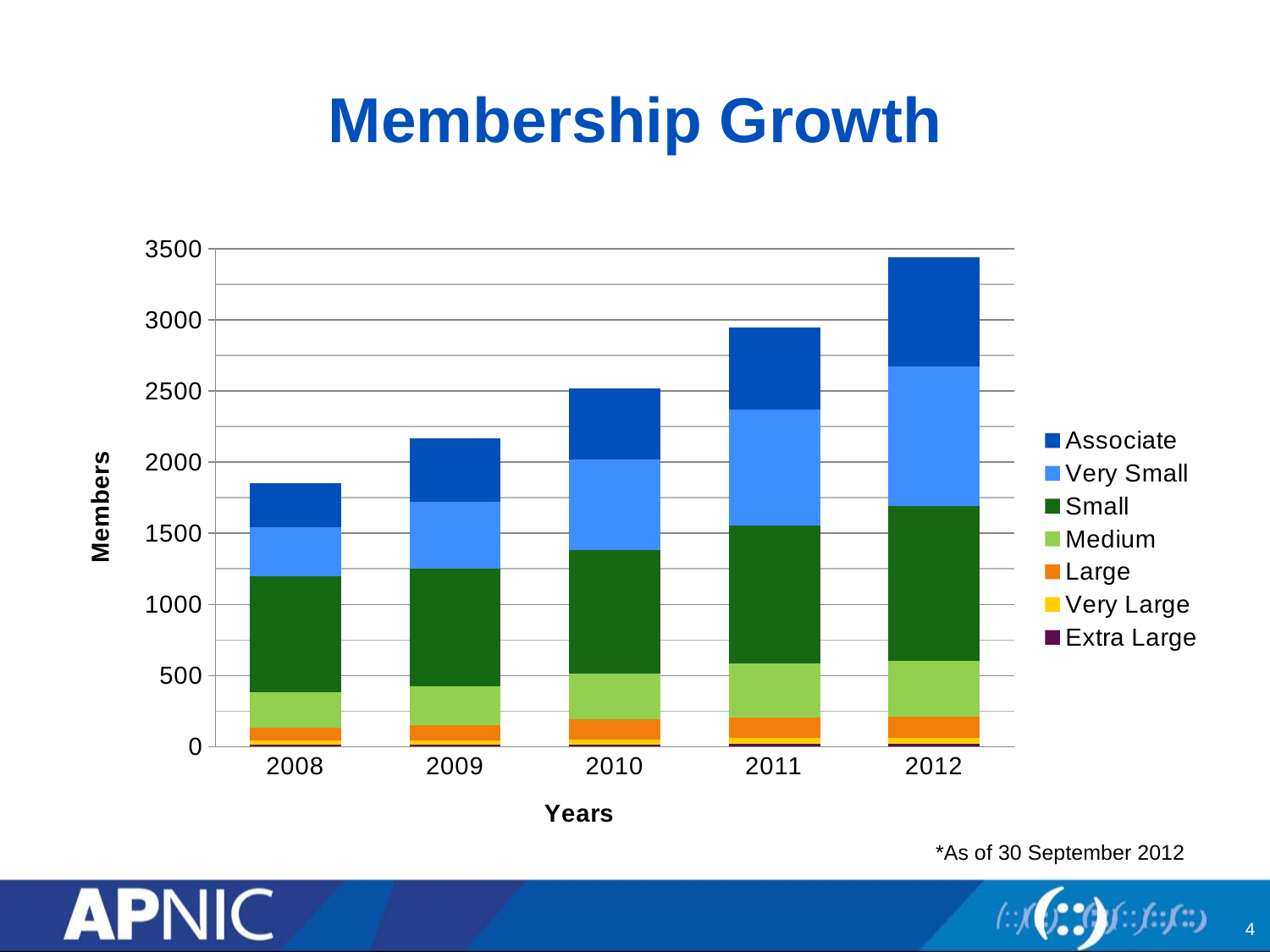
What kind of chart is shown on the slide? Stacked bar chart Which is larger in 2012, the Small segment or the Medium segment? Small Is the total number of members in 2011 greater or less than 2500? greater Is the total number of members in 2012 greater or less than 3000? greater What is the title of the chart? Membership Growth How many years are shown on the x axis? 5 How many series does the legend list? 7 Which year has the lowest total number of members? 2008 What is the label on the y axis? Members Is the total number of members in 2008 greater or less than 2000? less Do total members rise or fall from 2008 to 2012? Rise Which year has the highest total number of members? 2012